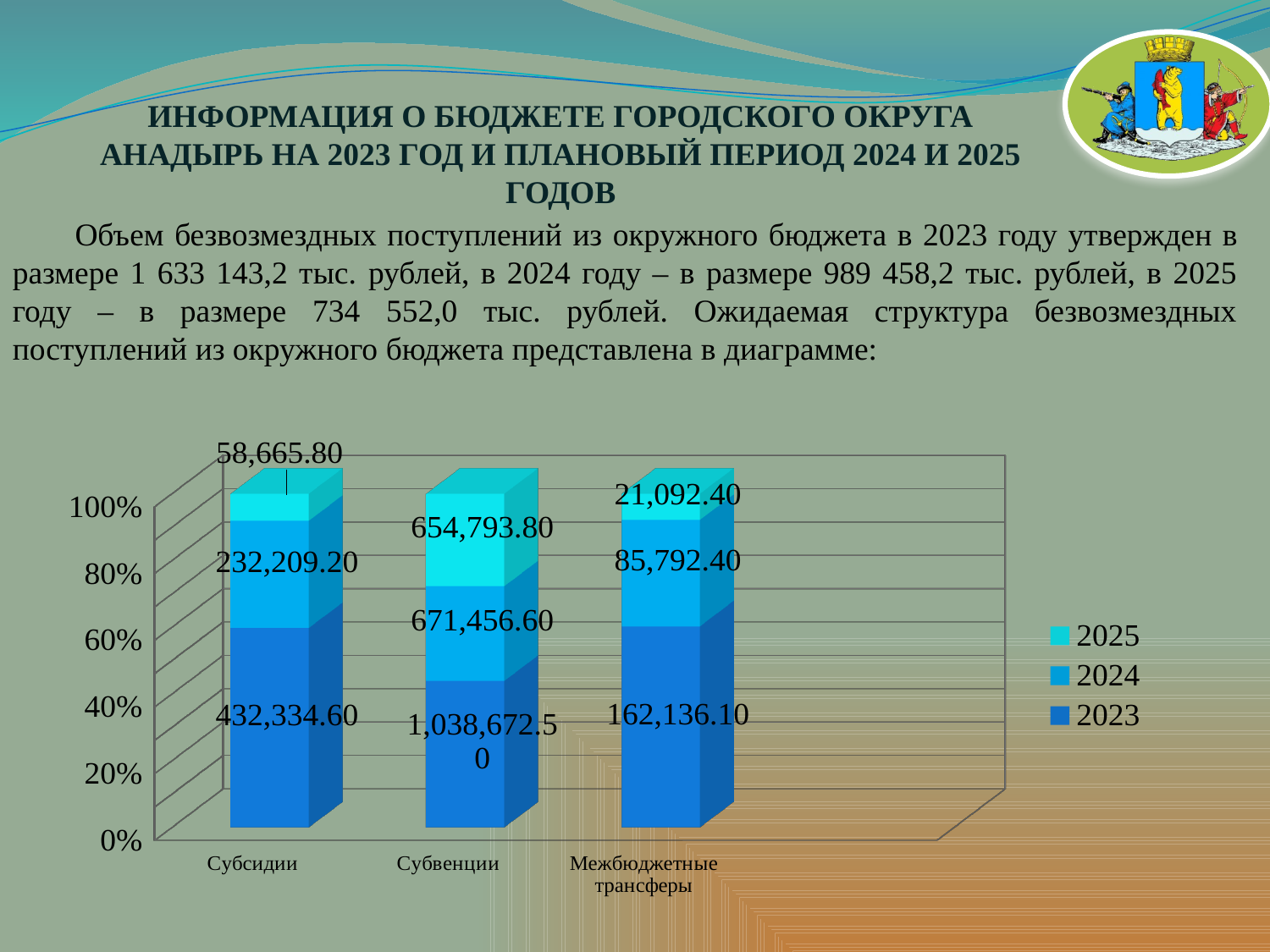
How many series does the legend list? 3 What kind of chart is shown on the slide? Stacked bar chart What is the value for 2023 in the Субвенции category? 1,038,672.50 How many categories are shown on the x axis? 3 What is the value for 2023 in the Субсидии category? 432,334.60 What is the value for 2024 in the Межбюджетные трансферы category? 85,792.40 Which category has the highest value for 2023? Субвенции What is the difference between the 2023 and 2024 values for Субсидии? 200,125.40 What is the total of the three values in the Межбюджетные трансферы bar? 269,020.90 Which category has the lowest value for 2025? Межбюджетные трансферы What is the value for 2025 in the Субвенции category? 654,793.80 Which is larger, the 2024 value for Субсидии or the 2024 value for Межбюджетные трансферы? Субсидии